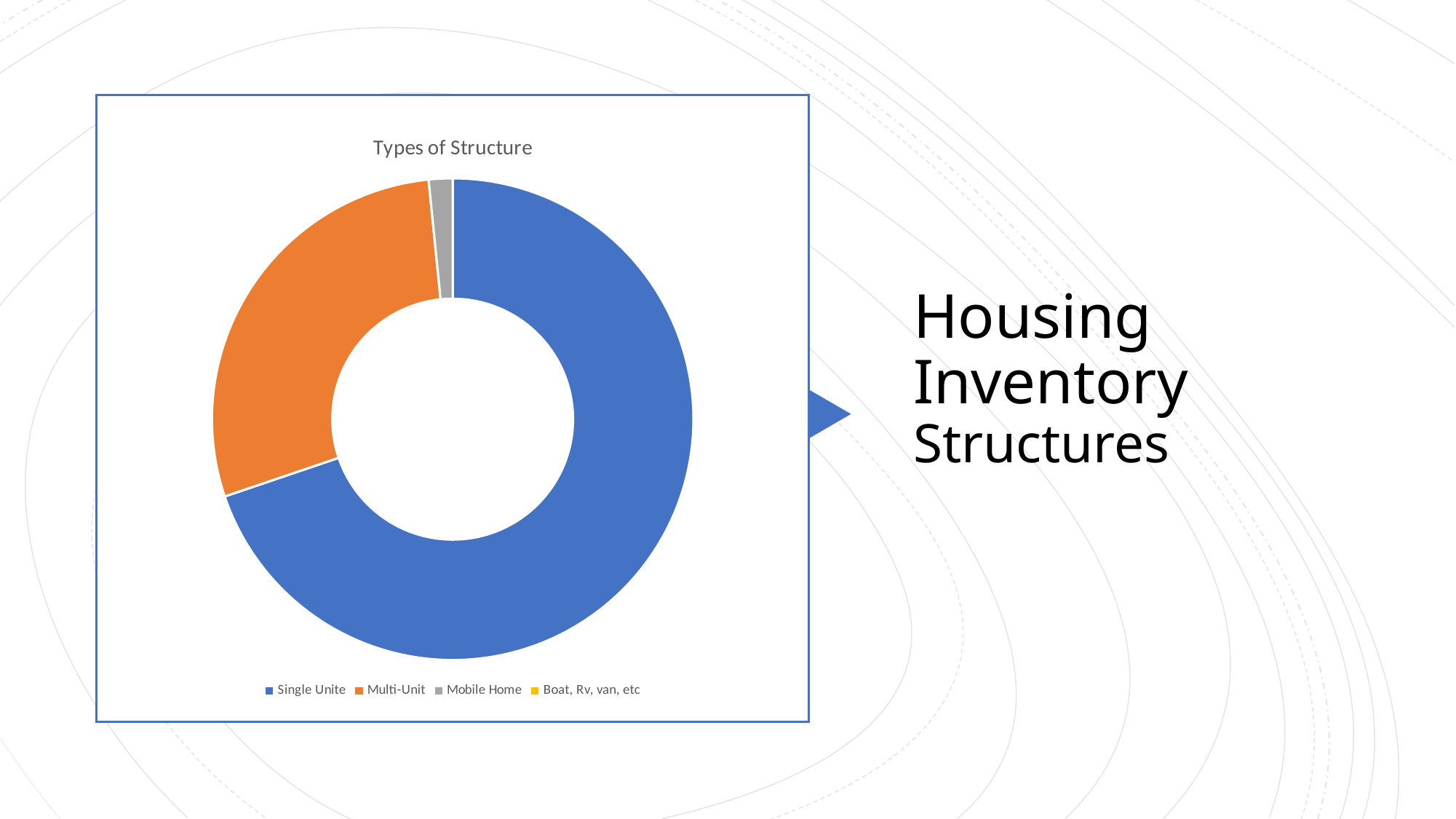
Does the Single Unite slice account for more or less than half of the chart? more Which is larger, the slice for Multi-Unit or the slice for Mobile Home? Multi-Unit Which colour represents Multi-Unit in the chart? orange What is the title of the chart? Types of Structure What kind of chart is shown on the slide? doughnut chart Which category is shown in grey in the chart? Mobile Home How many categories does the chart's legend list? 4 Which is larger, the slice for Single Unite or the slice for Multi-Unit? Single Unite Which category has the largest slice in the chart? Single Unite Does the Multi-Unit slice account for more or less than half of the chart? less